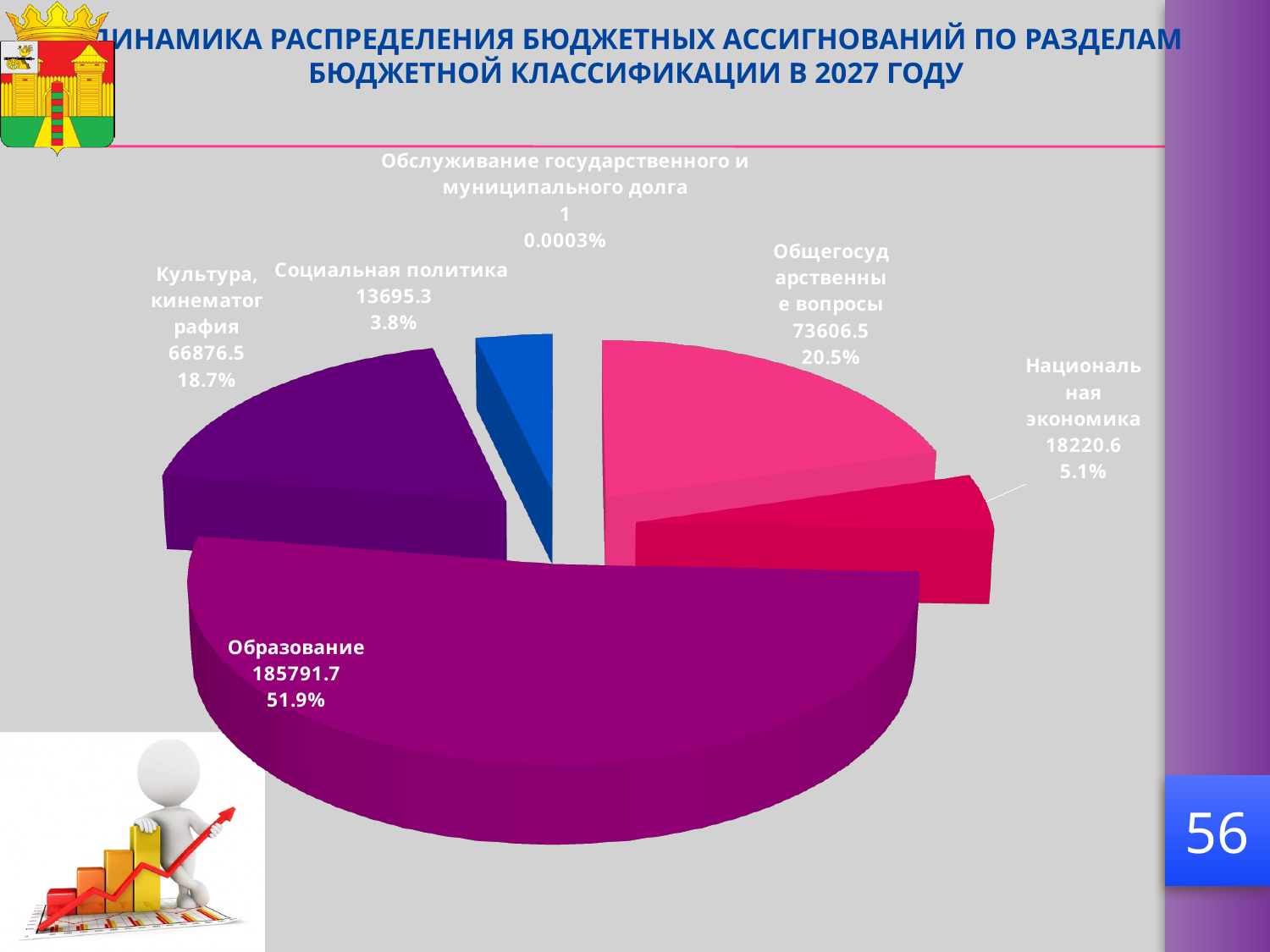
How many categories (slices) does the pie chart show? 6 What is the difference between the values for Общегосударственные вопросы and Национальная экономика? 55385.9 Which category has the smallest value? Обслуживание государственного и муниципального долга What share of the pie does Социальная политика represent? 3.8% Which category has the largest value? Образование What is the value for Общегосударственные вопросы? 73606.5 What is the value for Национальная экономика? 18220.6 What share of the pie does Образование represent? 51.9% What share of the pie does Культура, кинематография represent? 18.7% Which is larger, Общегосударственные вопросы or Культура, кинематография? Общегосударственные вопросы What is the value for Образование? 185791.7 What kind of chart is shown on the slide? Pie chart